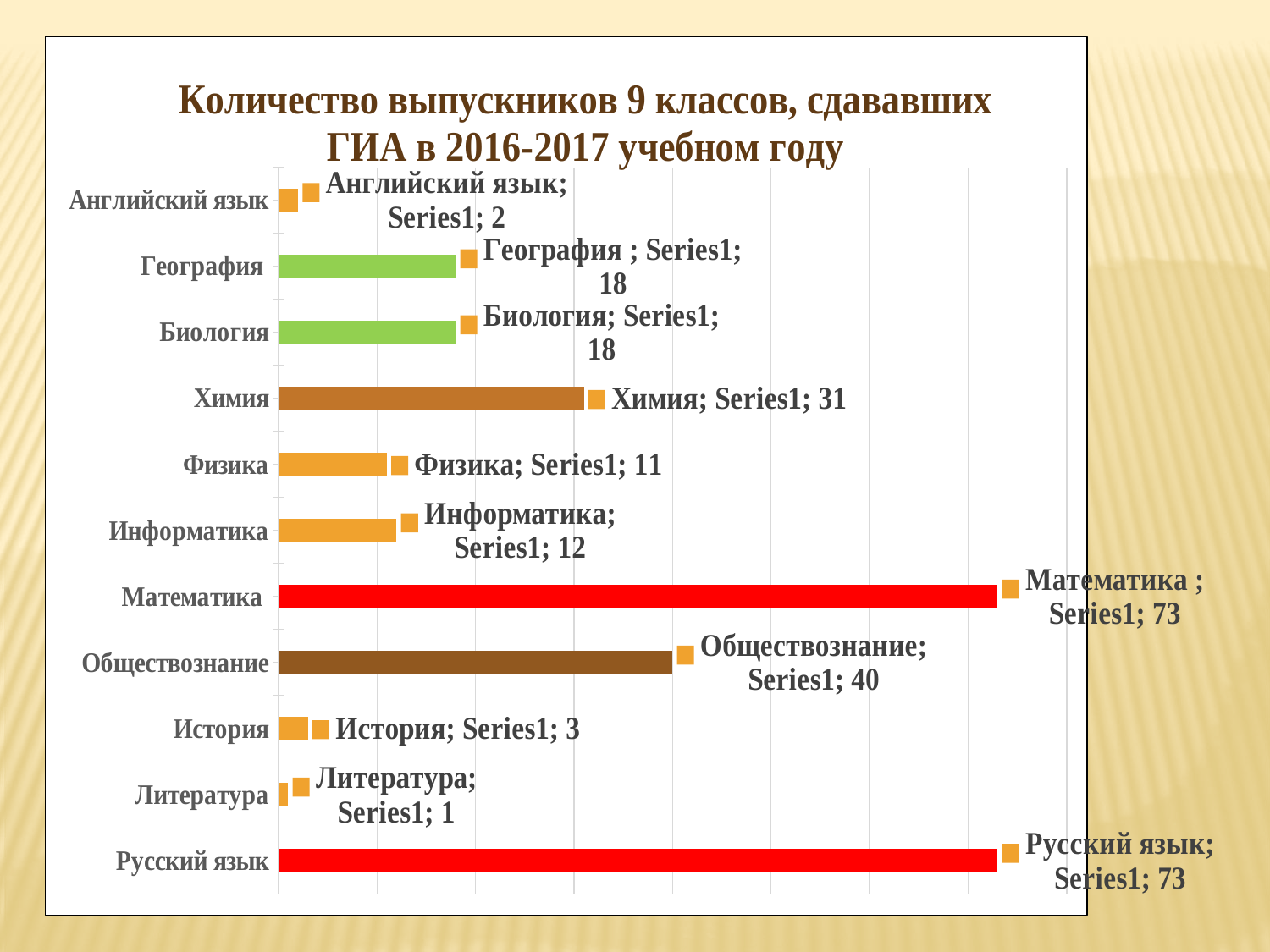
What is the value for Обществознание? 40 What is the value for Химия? 31 What is the highest value shown in the chart? 73 What is the difference between the values for Обществознание and Химия? 9 Which is larger, the value for Физика or the value for Информатика? Информатика What is the value for Математика? 73 What kind of chart is shown on the slide? bar chart What is the title of the chart? Количество выпускников 9 классов, сдававших ГИА в 2016-2017 учебном году How many categories (subjects) are plotted in the chart? 11 What is the difference between the values for Математика and Обществознание? 33 Which subject has the lowest value? Литература What is the value for Информатика? 12